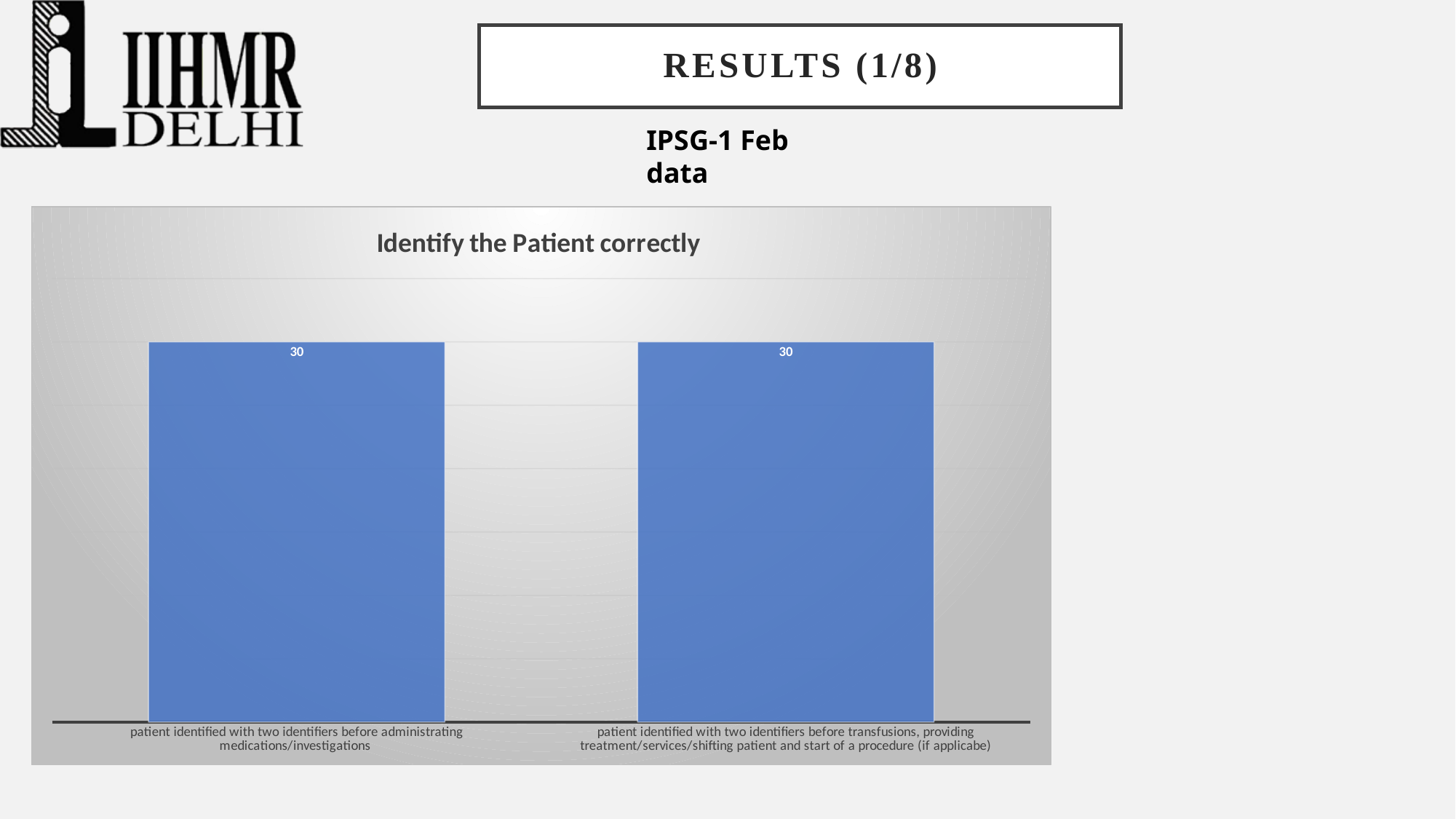
What is the title of the chart? Identify the Patient correctly What kind of chart is shown on the slide? bar chart Do the two bars have the same value? yes What is the total of the two bar values? 60 What is the value for 'patient identified with two identifiers before administrating medications/investigations'? 30 How many categories are shown on the chart? 2 What colour are the bars in the chart? blue What is the difference between the two bars' values? 0 What is the value for 'patient identified with two identifiers before transfusions, providing treatment/services/shifting patient and start of a procedure (if applicabe)'? 30